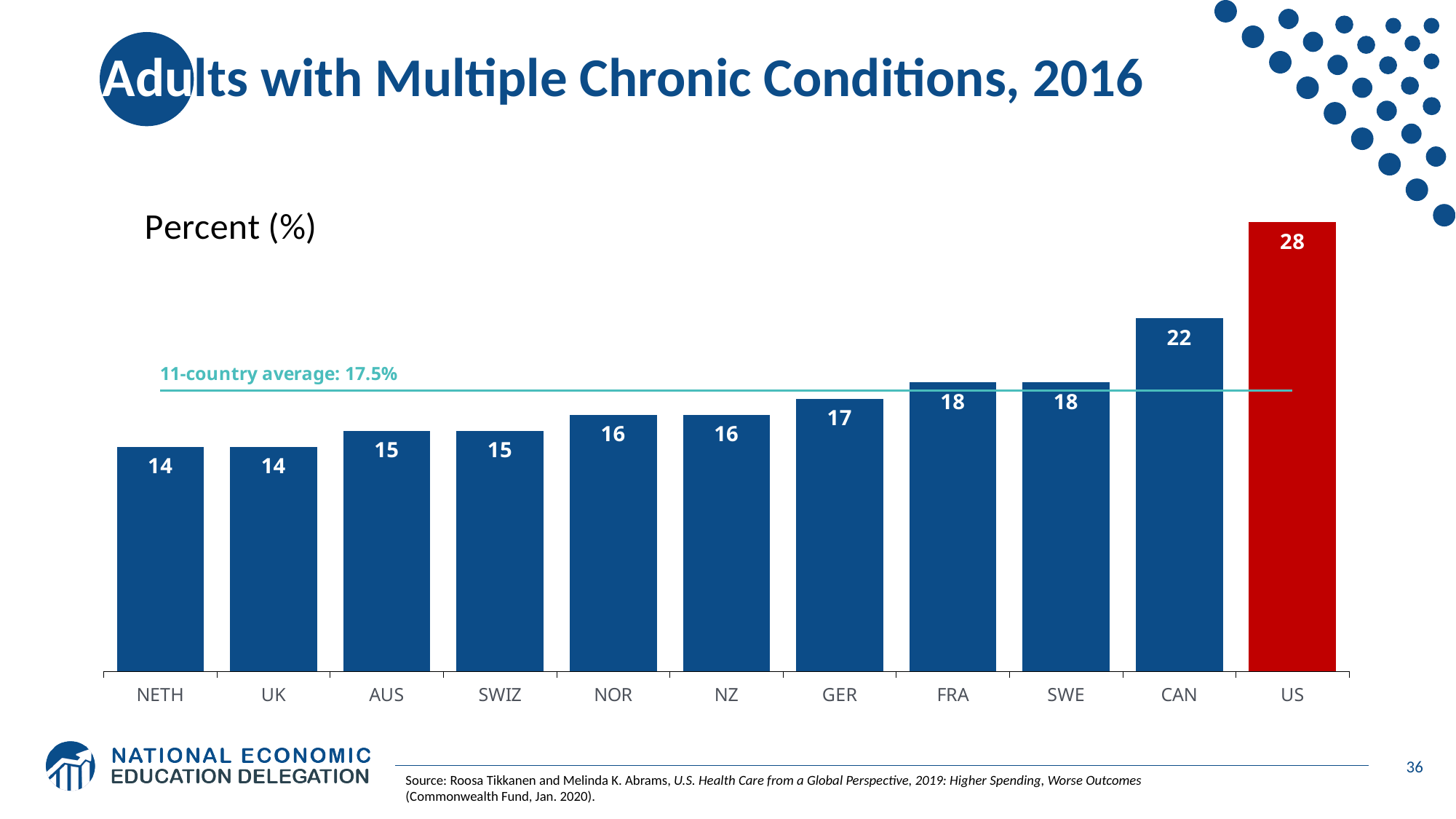
What is the difference between the US value and the Canada (CAN) value? 6 What is the value for Germany (GER)? 17 What is the value for Canada (CAN)? 22 What is the difference between the value for France (FRA) and the value for the Netherlands (NETH)? 4 Which country's bar is coloured red? US What kind of chart is shown on the slide? Bar chart How many countries are shown on the chart? 11 What is the value for the US? 28 Which is larger, the value for Norway (NOR) or the value for Australia (AUS)? NOR Do the values rise or fall from left to right along the x axis? Rise Which country has the highest value? US What is the 11-country average shown on the chart? 17.5%